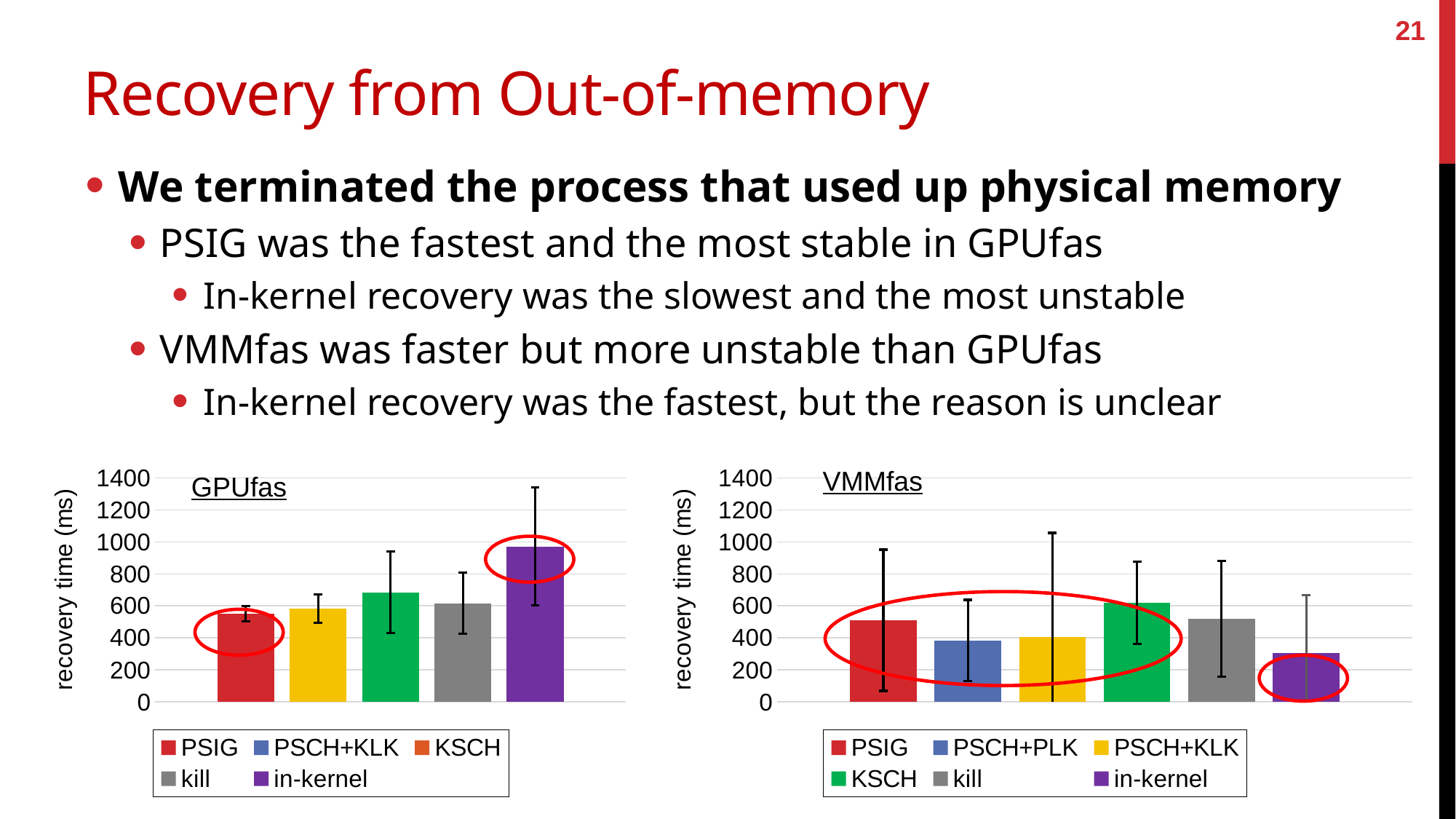
In the VMMfas chart, which series has the lowest recovery time? in-kernel What kind of chart is the GPUfas chart? bar chart In the VMMfas chart, is the recovery time for in-kernel greater or less than 400? less In the VMMfas chart, which series has the highest recovery time? KSCH In the VMMfas chart, how many series does the legend list? 6 In the VMMfas chart, is the recovery time for KSCH greater or less than 400? greater In the VMMfas chart, which has the larger recovery time, PSIG or in-kernel? PSIG In the GPUfas chart, is the recovery time for in-kernel greater or less than 800? greater In the GPUfas chart, which series has the highest recovery time? in-kernel What is the y-axis label on the GPUfas chart? recovery time (ms) In the VMMfas chart, how many bars are plotted? 6 In the GPUfas chart, how many series does the legend list? 5